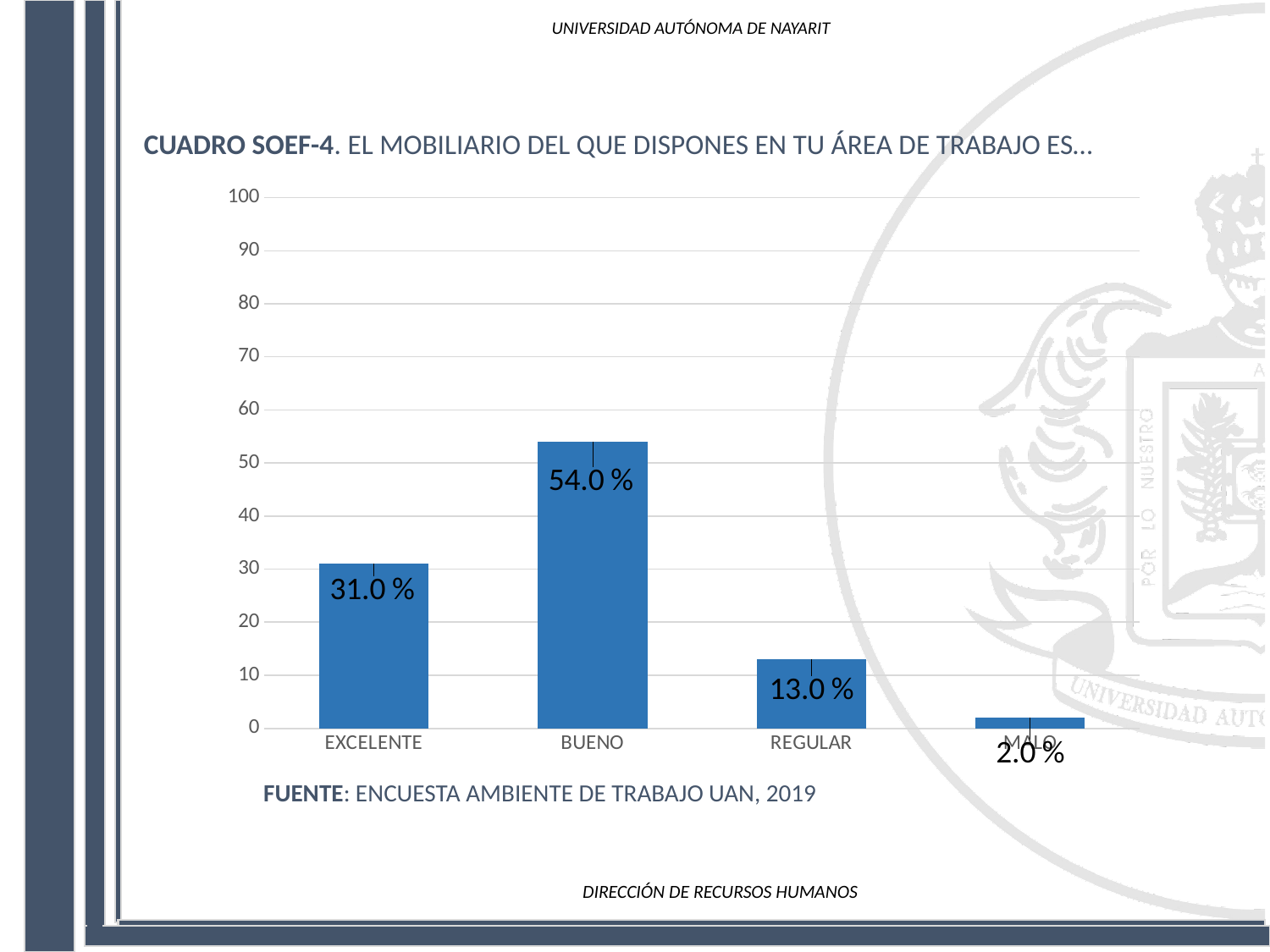
What is the difference between the values for EXCELENTE and REGULAR? 18.0 % What is the value for BUENO? 54.0 % Is the value for BUENO greater or less than 50? greater What source is cited below the chart? ENCUESTA AMBIENTE DE TRABAJO UAN, 2019 What is the value for REGULAR? 13.0 % Which category has the lowest value? MALO What is the value for EXCELENTE? 31.0 % How many categories are shown on the x axis? 4 Which category has the highest value? BUENO What kind of chart is shown on the slide? bar chart Which is larger, the value for EXCELENTE or the value for REGULAR? EXCELENTE What is the difference between the values for BUENO and EXCELENTE? 23.0 %